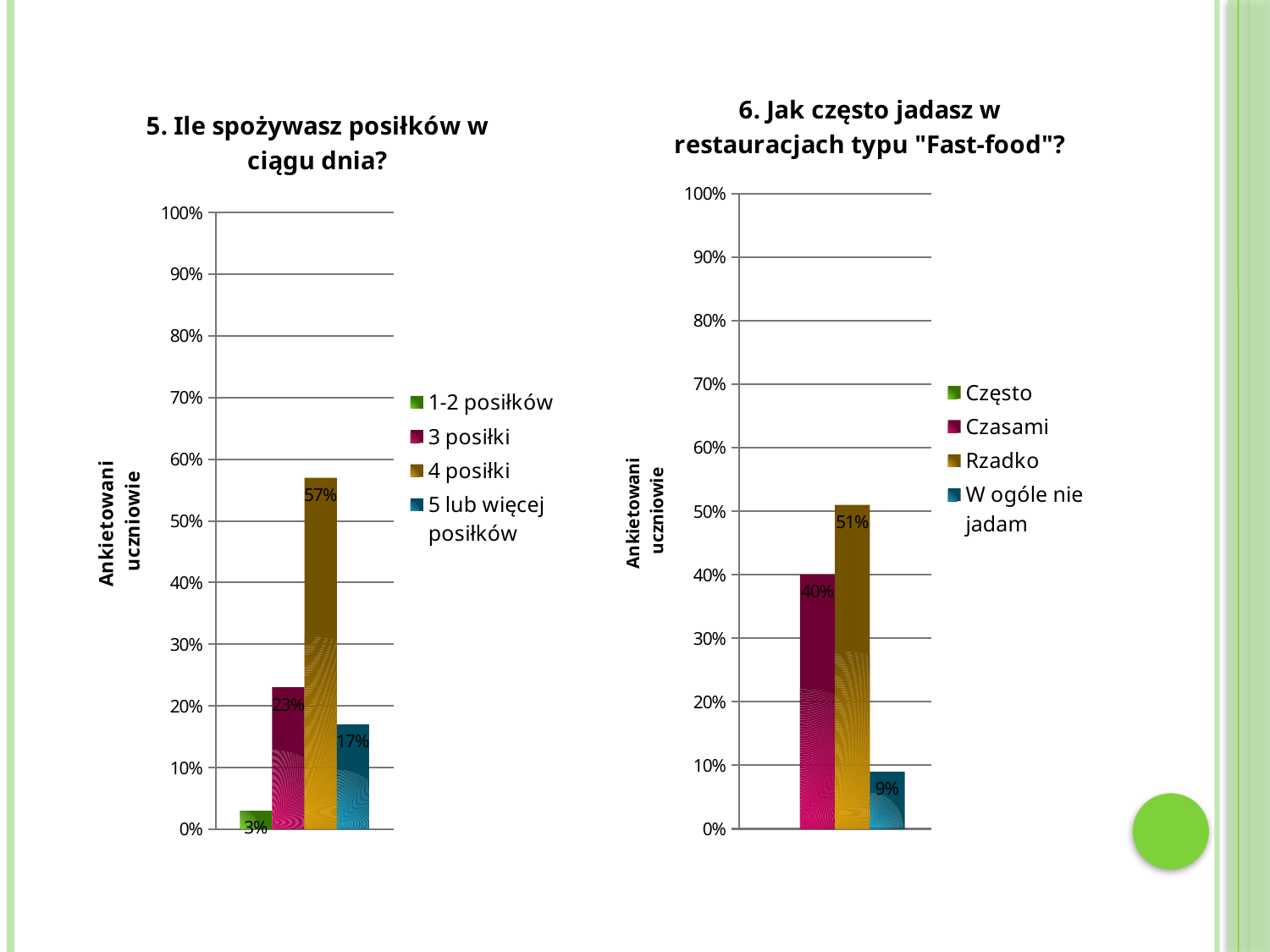
In the chart titled "5. Ile spożywasz posiłków w ciągu dnia?", how many series does the legend list? 4 In the chart titled "5. Ile spożywasz posiłków w ciągu dnia?", what is the value for "4 posiłki"? 57% In the chart titled "6. Jak często jadasz w restauracjach typu "Fast-food"?", what is the value for "W ogóle nie jadam"? 9% In the chart titled "6. Jak często jadasz w restauracjach typu "Fast-food"?", what is the difference between the values for "Rzadko" and "Czasami"? 11% In the chart titled "5. Ile spożywasz posiłków w ciągu dnia?", which series has the highest value? 4 posiłki In the chart titled "5. Ile spożywasz posiłków w ciągu dnia?", what is the value for "1-2 posiłków"? 3% In the chart titled "5. Ile spożywasz posiłków w ciągu dnia?", is the value for "3 posiłki" greater or less than 20%? greater In the chart titled "5. Ile spożywasz posiłków w ciągu dnia?", what is the difference between the values for "3 posiłki" and "5 lub więcej posiłków"? 6% In the chart titled "6. Jak często jadasz w restauracjach typu "Fast-food"?", what is the value for "Rzadko"? 51% In the chart titled "6. Jak często jadasz w restauracjach typu "Fast-food"?", what is the label of the vertical axis? Ankietowani uczniowie In the chart titled "6. Jak często jadasz w restauracjach typu "Fast-food"?", which is larger, "Czasami" or "Rzadko"? Rzadko What kind of chart is the one titled "6. Jak często jadasz w restauracjach typu "Fast-food"?"? Bar chart